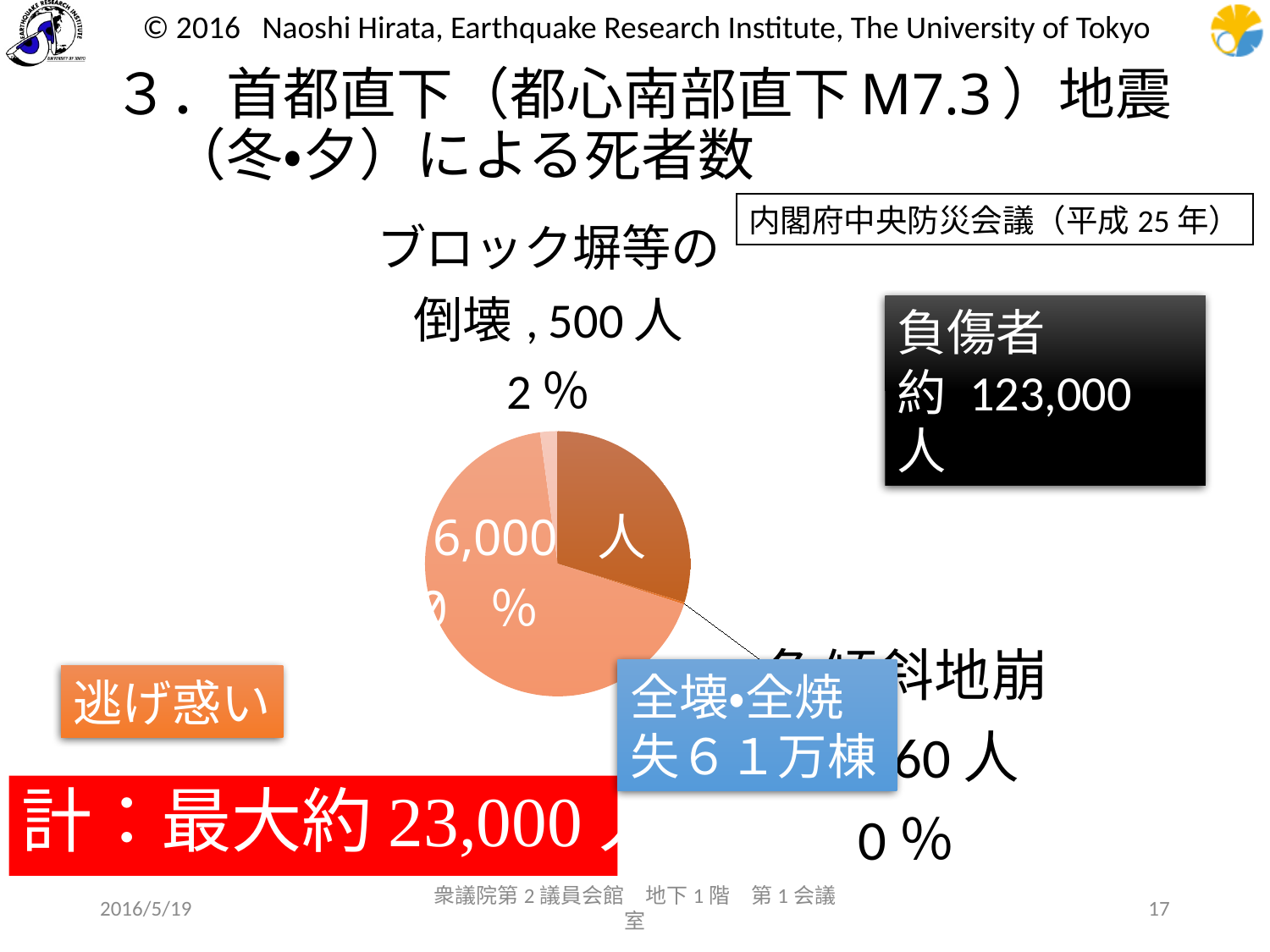
What earthquake scenario does the slide title say the death-toll pie chart is for? 首都直下（都心南部直下M7.3）地震（冬・夕） Is the ブロック塀等の倒壊 slice one of the smallest or one of the largest slices in the pie? one of the smallest How many deaths does the pie chart attribute to ブロック塀等の倒壊? 500人 What share of the pie does the ブロック塀等の倒壊 slice represent? 2% What kind of chart is shown on the slide? pie chart According to the slide, what is the source of the data shown in the pie chart? 内閣府中央防災会議（平成25年）